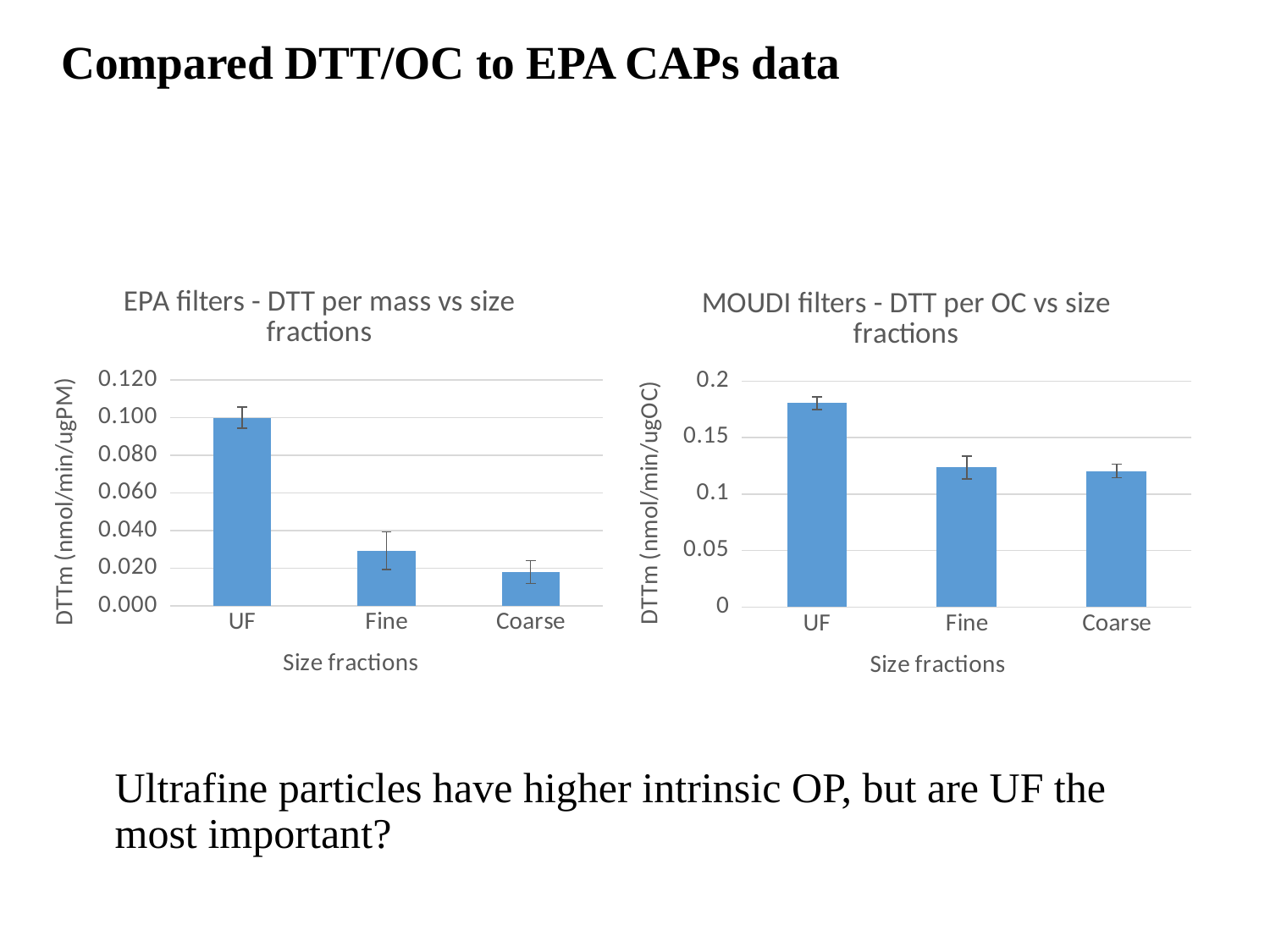
In the left chart, 'EPA filters - DTT per mass vs size fractions', which size fraction has the lowest DTTm value? Coarse In the right chart, 'MOUDI filters - DTT per OC vs size fractions', is the value for UF greater or less than 0.15? greater In the left chart, 'EPA filters - DTT per mass vs size fractions', is the value for Fine greater or less than 0.040? less In the left chart, 'EPA filters - DTT per mass vs size fractions', how many size fraction categories are plotted? 3 In the right chart, 'MOUDI filters - DTT per OC vs size fractions', which size fraction has the highest DTTm value? UF In the right chart, 'MOUDI filters - DTT per OC vs size fractions', which is larger, the value for UF or the value for Fine? UF In the right chart, 'MOUDI filters - DTT per OC vs size fractions', is the value for Coarse greater or less than 0.15? less In the left chart, 'EPA filters - DTT per mass vs size fractions', which size fraction has the highest DTTm value? UF What is the y-axis label of the right chart, 'MOUDI filters - DTT per OC vs size fractions'? DTTm (nmol/min/ugOC) In the left chart, 'EPA filters - DTT per mass vs size fractions', do the values rise or fall from UF to Coarse along the x axis? fall In the left chart, 'EPA filters - DTT per mass vs size fractions', what kind of chart is shown? bar chart